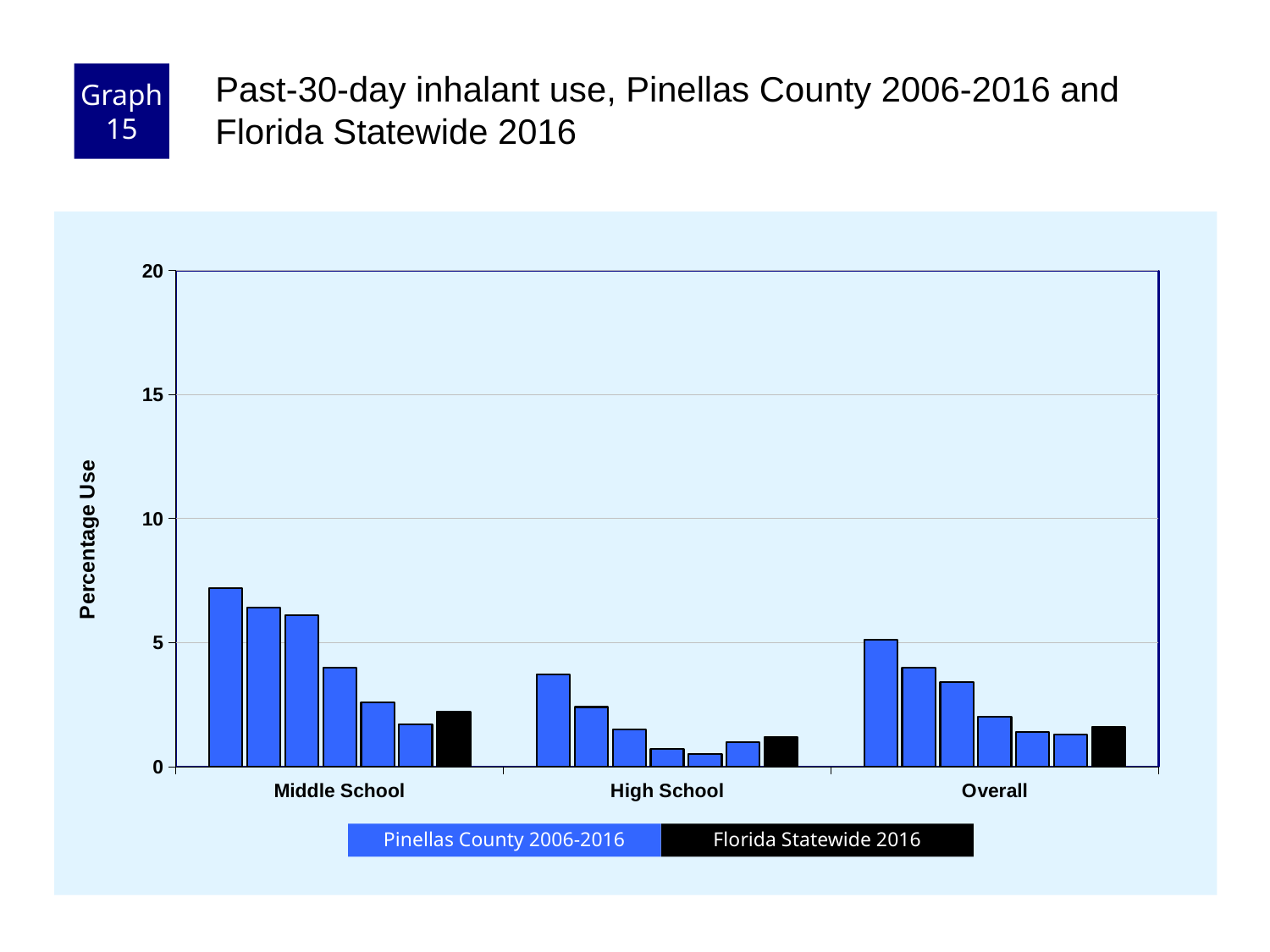
Is the Florida Statewide 2016 bar for Middle School greater or less than 5? less How many school-level categories are shown on the x axis? 3 Which category contains the tallest bar in the chart? Middle School How many series does the legend list? 2 Is the tallest Pinellas County bar for High School greater or less than 5? less Within the Middle School group, do the Pinellas County 2006-2016 bars rise or fall from left to right? fall Which is larger: the Florida Statewide 2016 bar for Middle School or for High School? Middle School What kind of chart is shown on the slide? bar chart Is the tallest Pinellas County bar for Middle School greater or less than 5? greater Which category has the lowest Florida Statewide 2016 bar? High School What is the label of the y axis? Percentage Use Which colour represents Florida Statewide 2016 in the legend? black